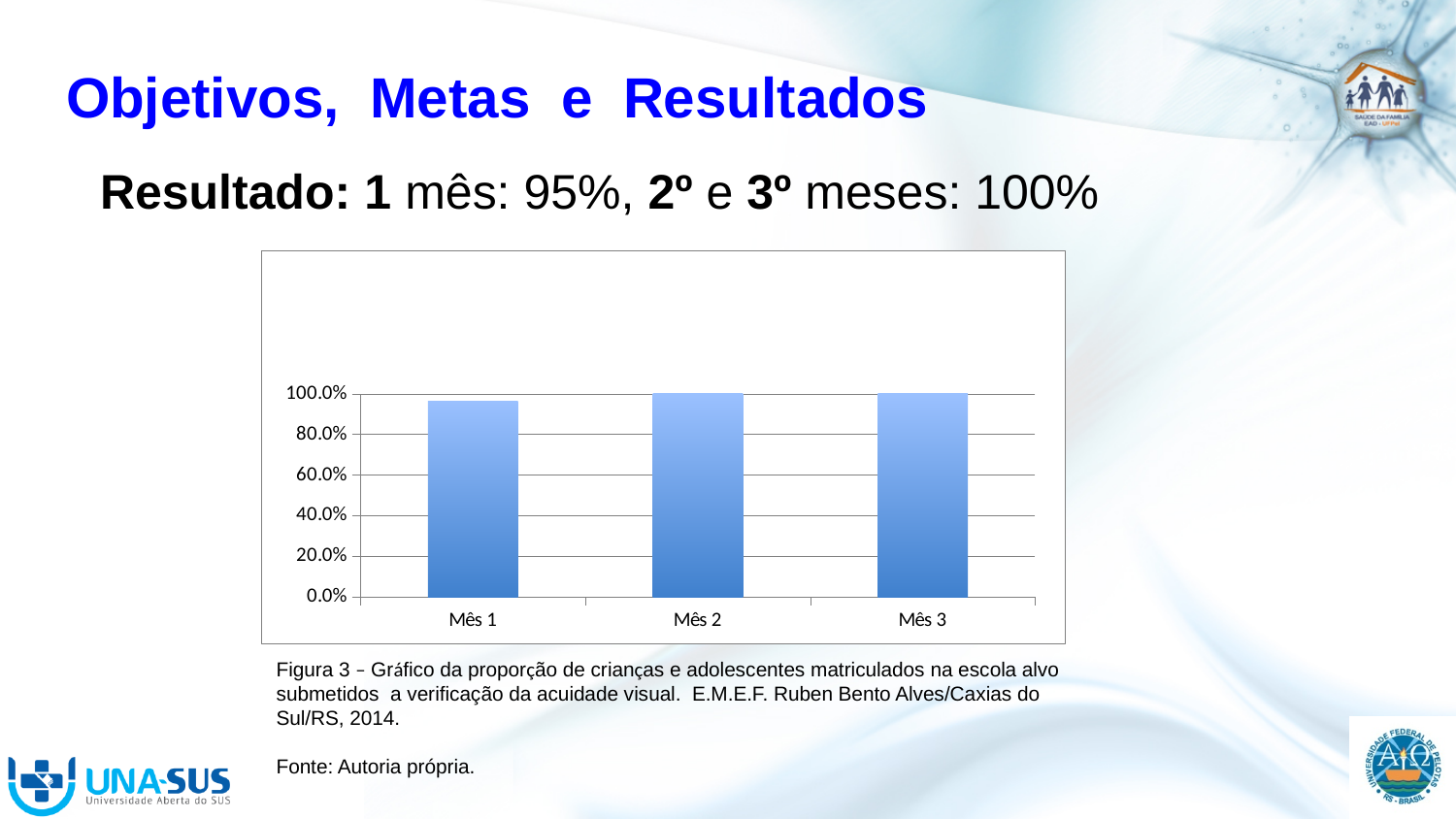
Which is larger, the value for Mês 3 or the value for Mês 1? Mês 3 What is the value for Mês 2 in the chart? 100.0% Which is larger, the value for Mês 1 or the value for Mês 2? Mês 2 What is the value for Mês 3 in the chart? 100.0% How many categories (months) are plotted on the x axis of the chart? 3 What is the label of the first category on the x axis of the chart? Mês 1 Which month has the lowest bar in the chart? Mês 1 Do the values rise or fall from Mês 1 to Mês 2? rise What kind of chart is shown on the slide? bar chart Is the value for Mês 1 greater or less than 100.0%? less What is the highest tick value shown on the y axis of the chart? 100.0% Is the value for Mês 1 greater or less than 80.0%? greater